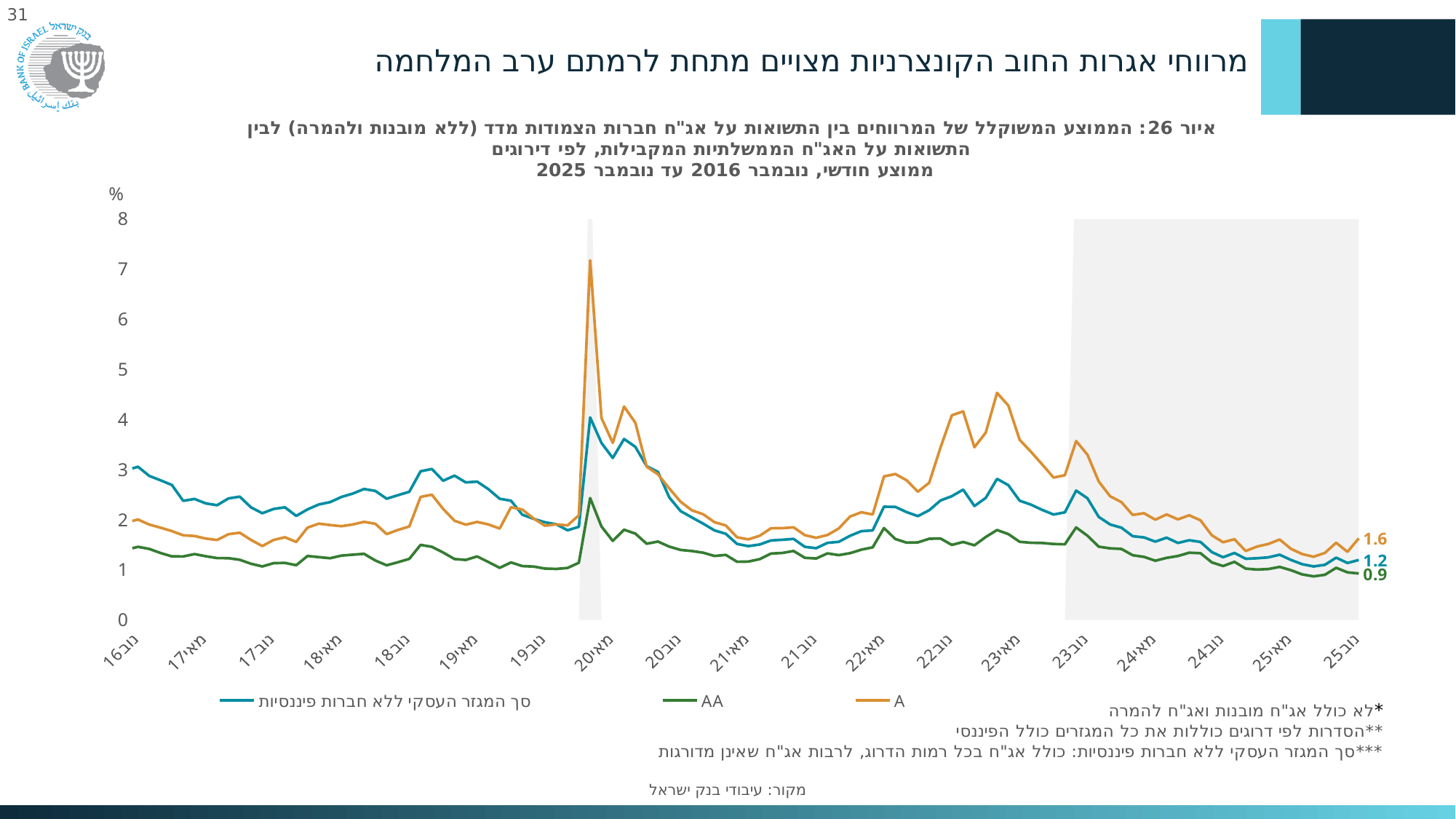
What is the final value (November 2025) of the A series? 1.6 Is the peak of the A series around May 2020 greater or less than 6? greater Which series has the lowest value at the end of the chart (November 2025)? AA What is the difference between the final values of the A series and the AA series? 0.7 What unit is shown on the y axis? % How many series does the legend list? 3 What is the final value (November 2025) of the series 'סך המגזר העסקי ללא חברות פיננסיות'? 1.2 What kind of chart is shown on the slide? line chart At the end of the chart, is the value of the A series larger or smaller than the value of the AA series? larger Is the value of the AA series in November 2016 greater or less than 2? less What is the final value (November 2025) of the AA series? 0.9 Which series has the highest value at the end of the chart (November 2025)? A